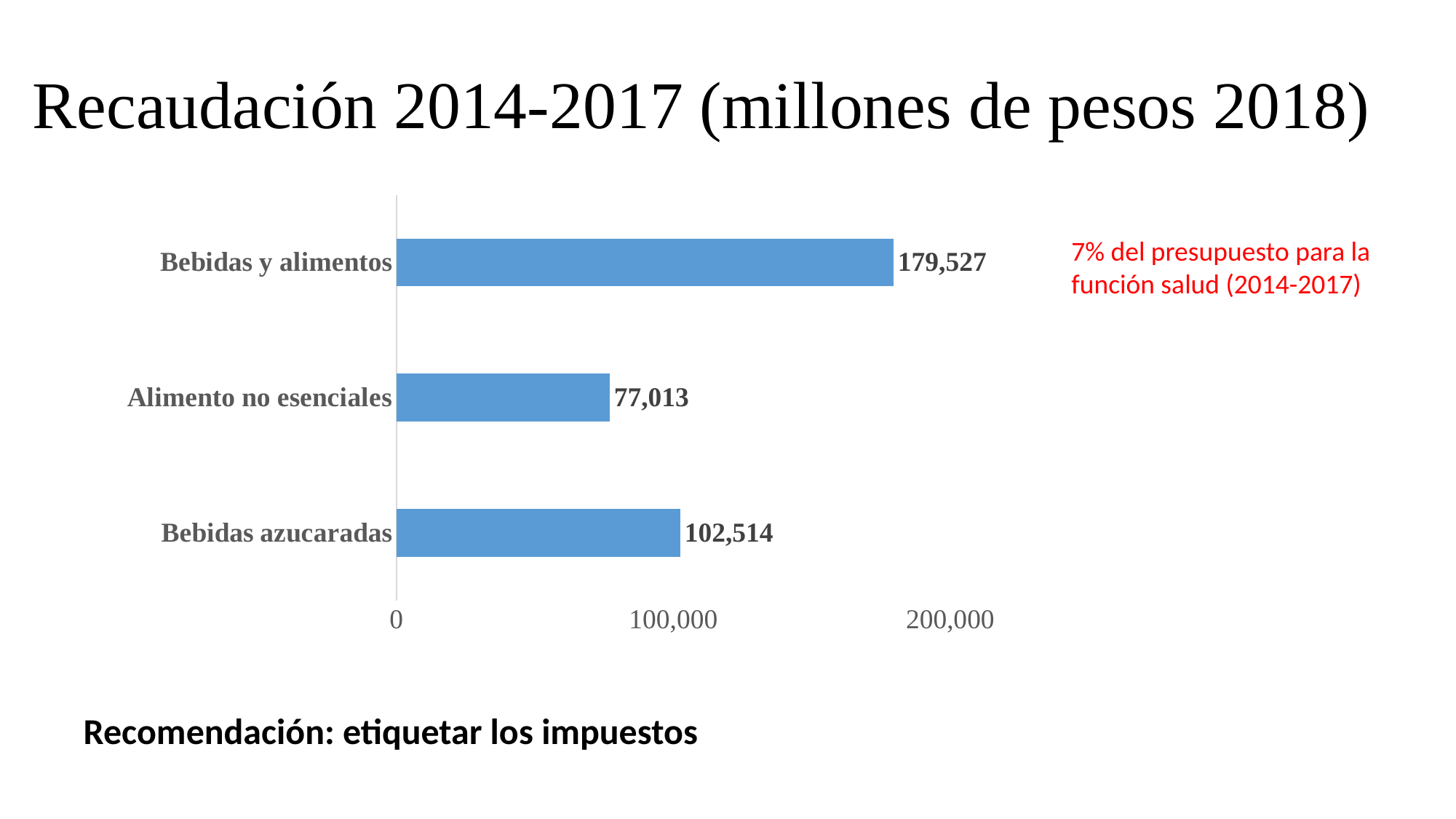
What is the value for Bebidas azucaradas? 102,514 Which category has the lowest value? Alimento no esenciales Is the value for Alimento no esenciales greater or less than 100,000? less What is the difference between the values for Bebidas azucaradas and Alimento no esenciales? 25,501 What is the difference between the values for Bebidas y alimentos and Bebidas azucaradas? 77,013 Which is larger, the value for Bebidas azucaradas or the value for Alimento no esenciales? Bebidas azucaradas What is the value for Alimento no esenciales? 77,013 What kind of chart is shown on the slide? bar chart How many categories are shown in the chart? 3 What is the value for Bebidas y alimentos? 179,527 What is the title of the slide containing the chart? Recaudación 2014-2017 (millones de pesos 2018) Which category has the highest value? Bebidas y alimentos